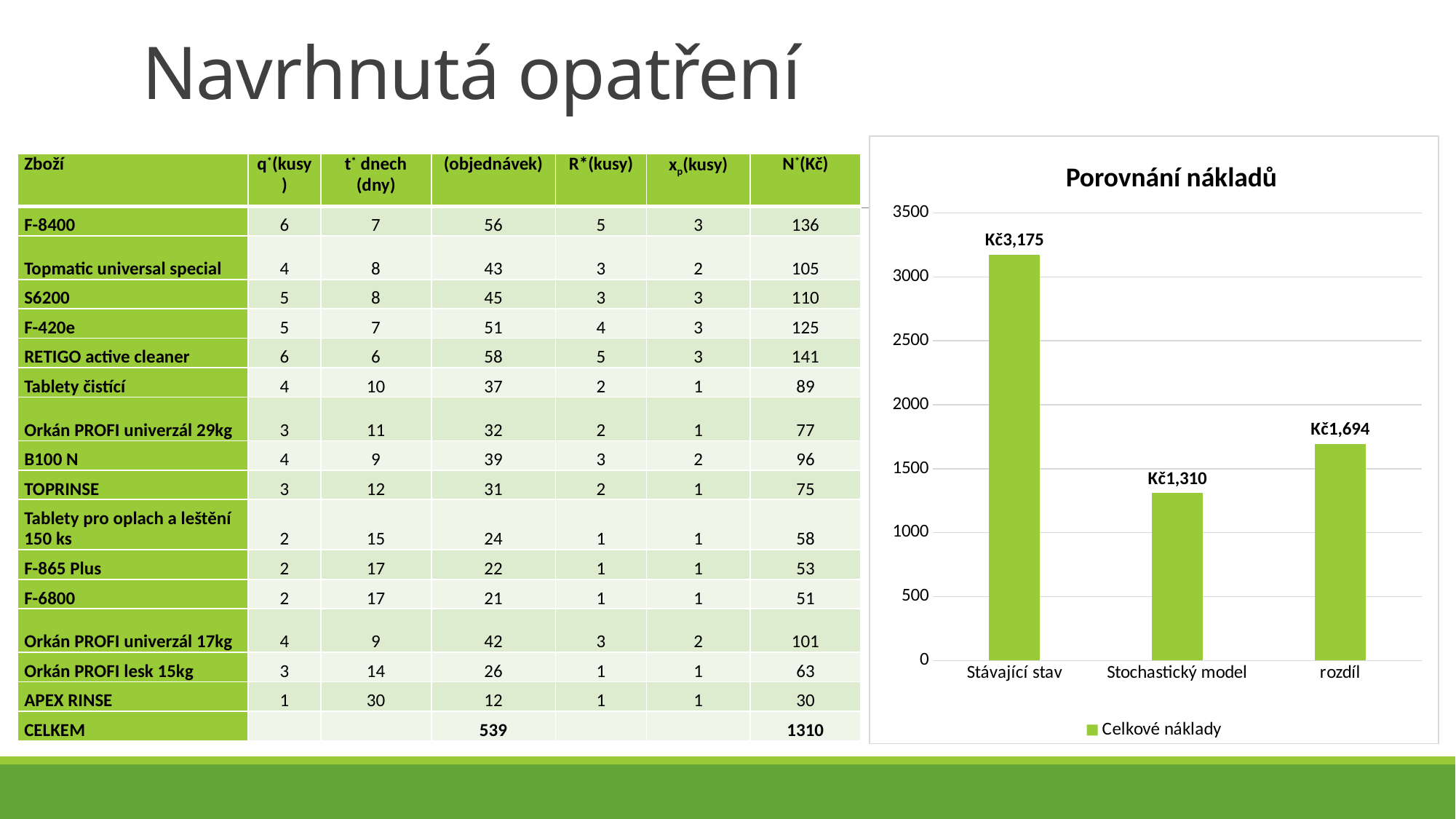
What kind of chart is the Porovnání nákladů chart? bar chart What is the difference between Stávající stav and Stochastický model in the Porovnání nákladů chart? Kč1,865 Which is larger in the Porovnání nákladů chart, rozdíl or Stochastický model? rozdíl What is the value for Stochastický model in the Porovnání nákladů chart? Kč1,310 How many categories are shown in the Porovnání nákladů chart? 3 What is the value for Stávající stav in the Porovnání nákladů chart? Kč3,175 What is the value for rozdíl in the Porovnání nákladů chart? Kč1,694 What is the legend entry in the Porovnání nákladů chart? Celkové náklady How many series does the legend of the Porovnání nákladů chart list? 1 Is the value for Stochastický model greater or less than 1500 in the Porovnání nákladů chart? less Which category has the highest value in the Porovnání nákladů chart? Stávající stav Which category has the lowest value in the Porovnání nákladů chart? Stochastický model